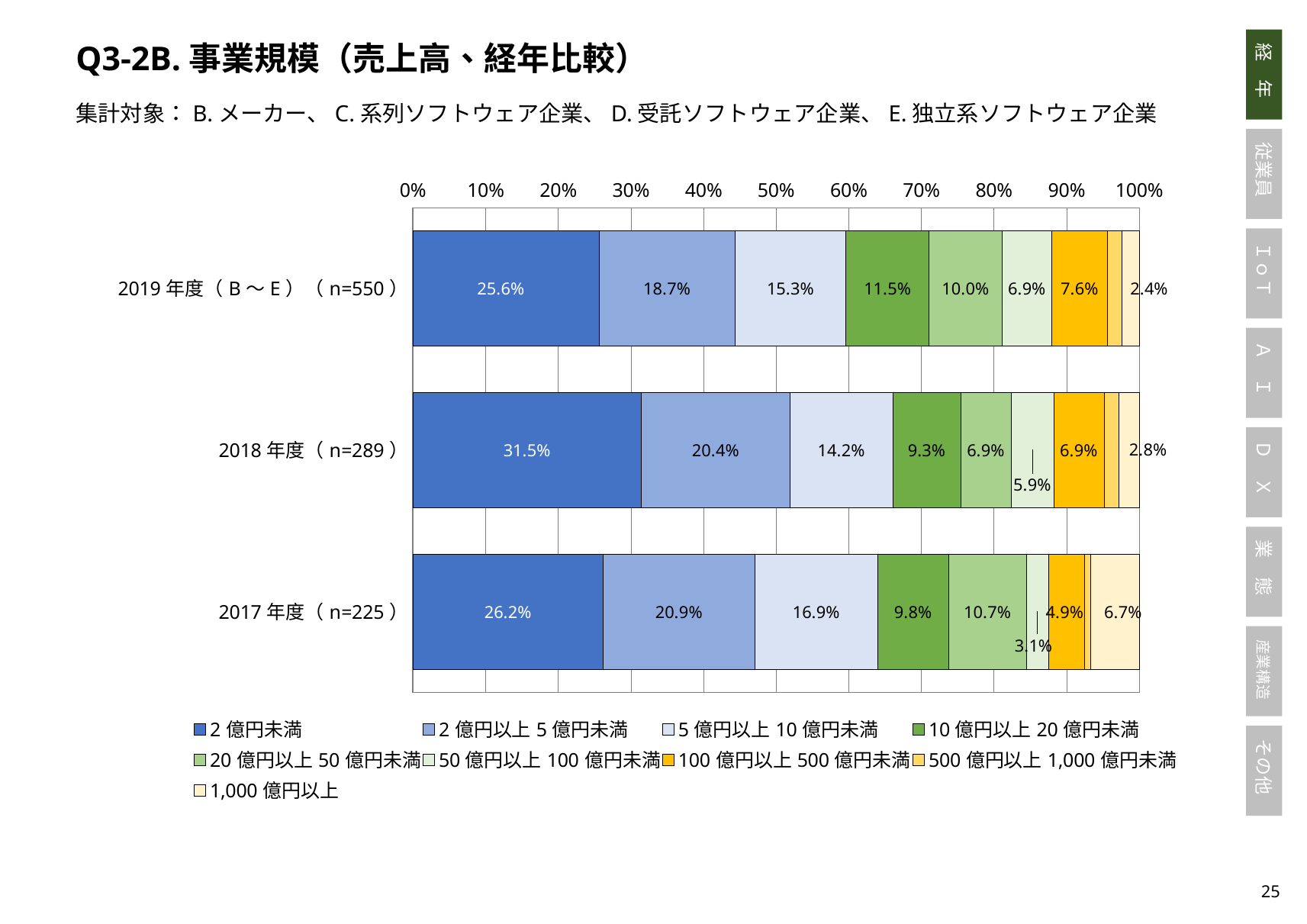
What is the share of 20億円以上50億円未満 for 2017年度? 10.7% Which has the larger share of 10億円以上20億円未満, 2019年度 or 2018年度? 2019年度 Which fiscal year has the highest share of 2億円未満? 2018年度 What kind of chart is shown on the slide? Stacked bar chart What is the difference in the 2億円未満 share between 2018年度 and 2017年度? 5.3 percentage points How many fiscal-year categories are plotted in the chart? 3 How many series does the legend list? 9 What is the sample size (n) shown for 2019年度? 550 What is the share of 5億円以上10億円未満 for 2019年度? 15.3% What is the share of 2億円未満 for 2018年度? 31.5% Which fiscal year has the lowest share of 50億円以上100億円未満? 2017年度 What is the share of 100億円以上500億円未満 for 2017年度? 4.9%